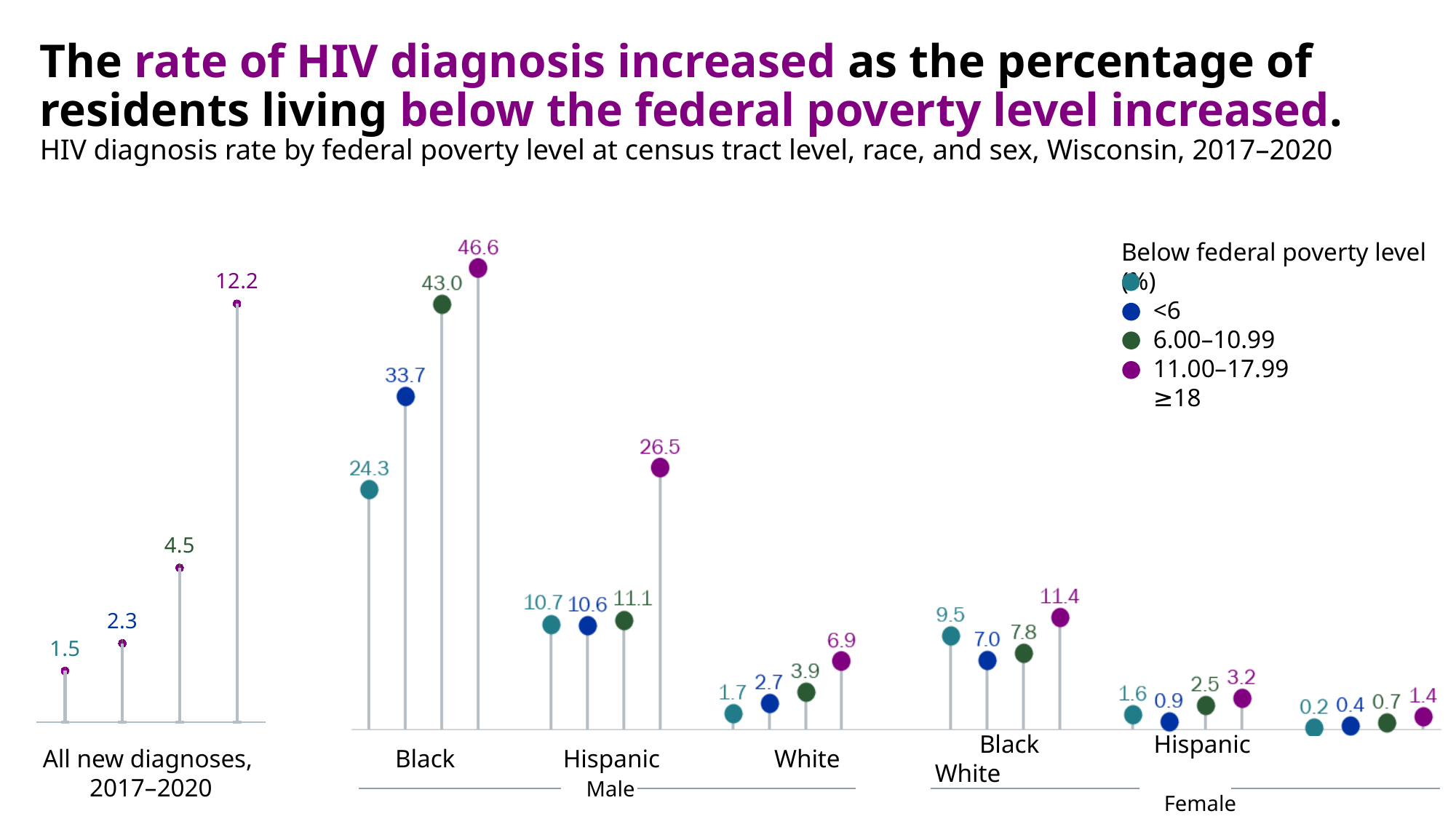
How many dots are plotted in each race/sex group? 4 Do the values in the 'All new diagnoses, 2017–2020' group rise or fall from left to right? rise What is the value of the teal (leftmost) dot in the Black male group? 24.3 What is the difference between the highest and lowest values in the Black male group? 22.3 What is the lowest value in the White male group? 1.7 What is the value of the green dot in the Black female group? 7.8 What is the highest value in the Hispanic female group? 3.2 What is the title of the legend on the chart? Below federal poverty level (%) What is the highest HIV diagnosis rate shown anywhere on the chart? 46.6 What is the value of the purple (rightmost) dot in the 'All new diagnoses, 2017–2020' group? 12.2 What is the difference between the purple dot (26.5) and the teal dot (10.7) in the Hispanic male group? 15.8 Which is larger: the purple dot for Hispanic males (26.5) or the purple dot for Black females (11.4)? Hispanic males